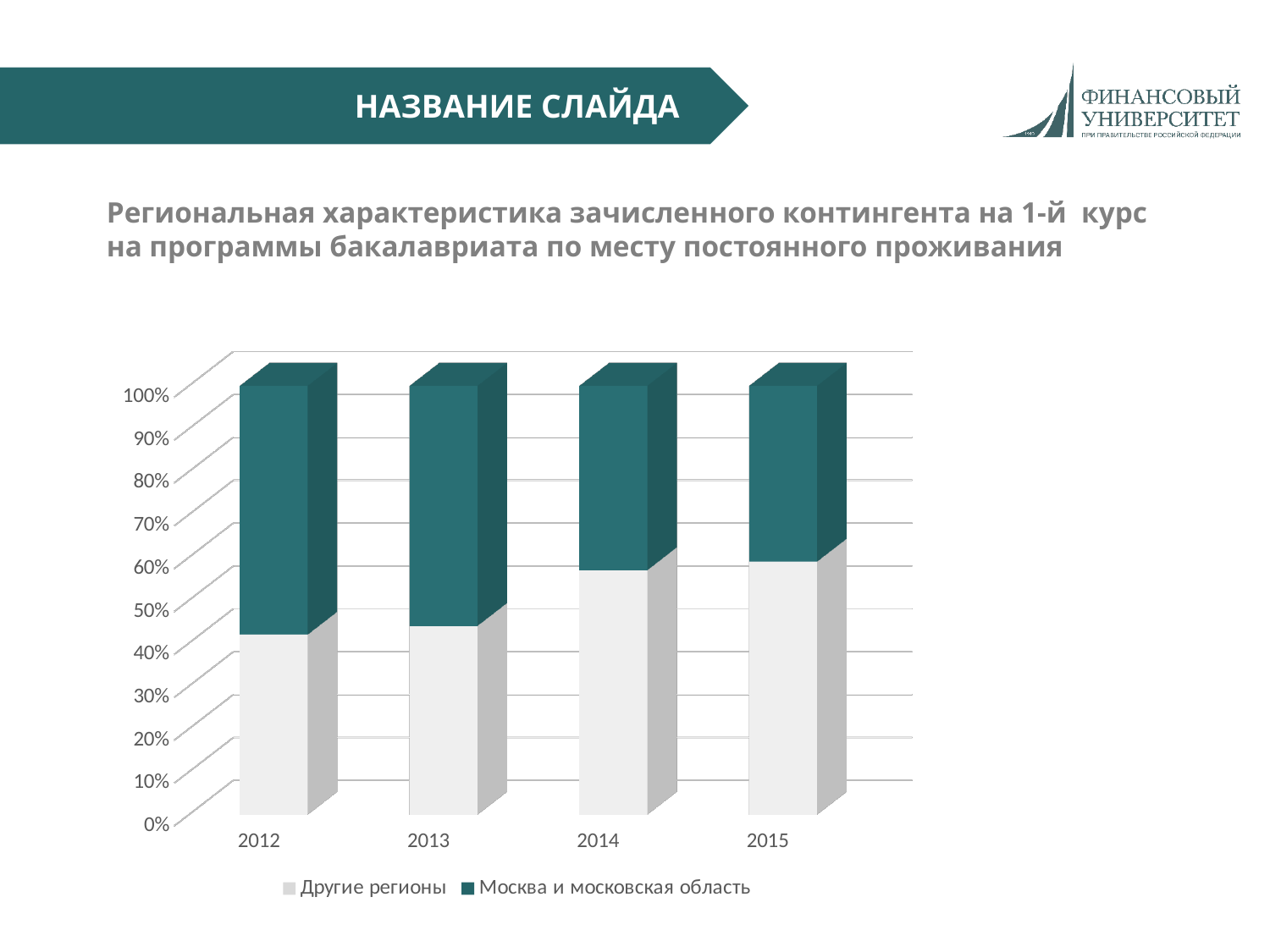
What kind of chart is shown on the slide? Stacked bar chart Does the share of Другие регионы rise or fall from 2012 to 2015? rise Is the share of Москва и московская область in 2013 greater or less than 50%? greater Is the share of Другие регионы in 2012 greater or less than 50%? less Which two series are listed in the chart legend? Другие регионы; Москва и московская область Which is larger: the share of Москва и московская область in 2012 or in 2015? 2012 Which series is shown in the dark teal colour? Москва и московская область Is the share of Другие регионы in 2015 greater or less than 50%? greater Which is larger: the share of Другие регионы in 2012 or in 2014? 2014 How many series does the chart legend list? 2 How many years are shown on the x axis of the chart? 4